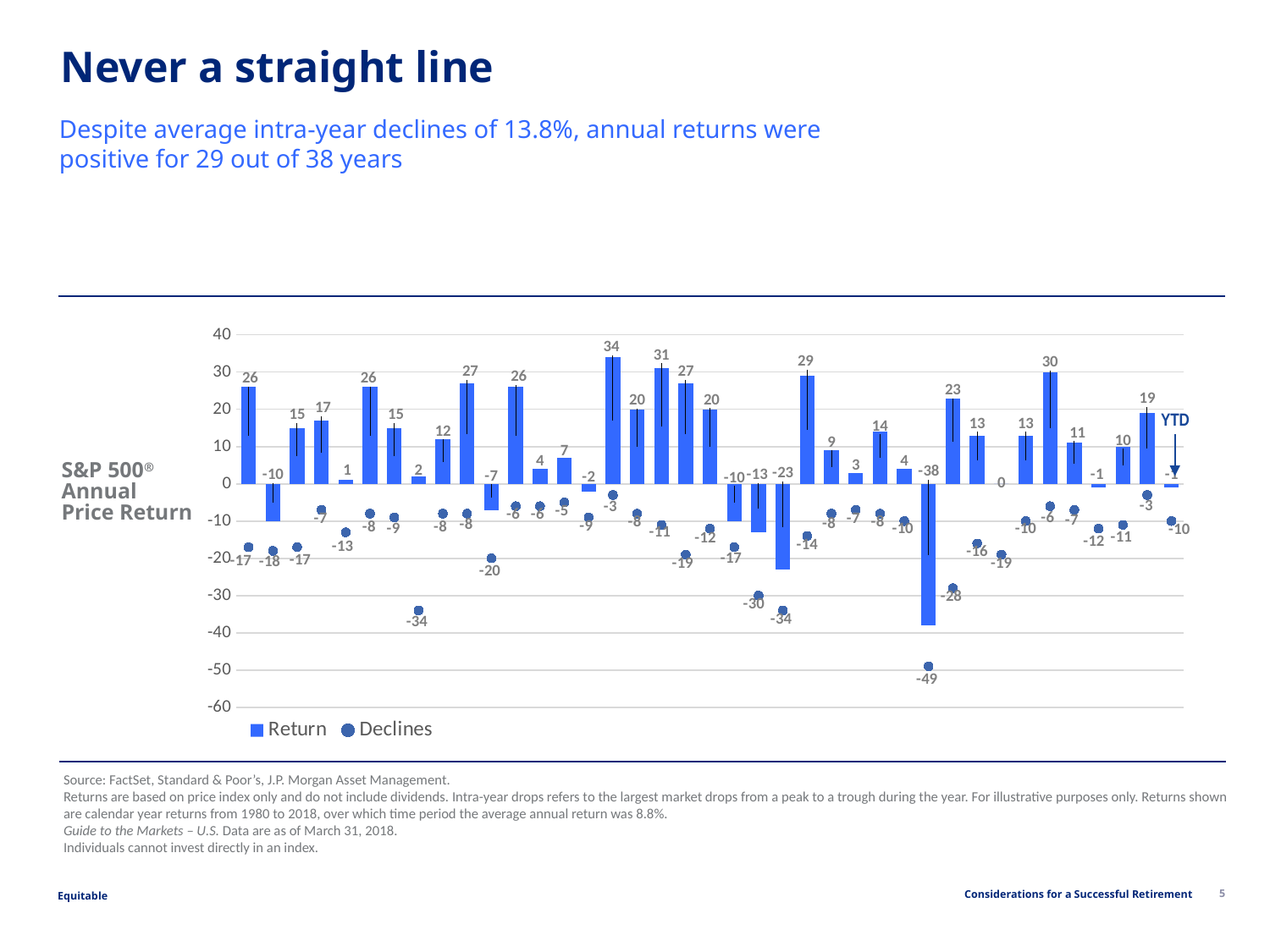
What is the largest intra-year decline shown on the chart? -49 What is the difference between the highest return (34) and the lowest return (-38)? 72 What is the lowest annual return value shown on the chart? -38 Is the lowest return bar (-38) greater or less than -30? less What is the label on the vertical axis of the chart? S&P 500 Annual Price Return What is the return value for the YTD bar? -1 What is the highest annual return value shown on the chart? 34 What are the two series named in the legend? Return and Declines What is the decline value for the YTD point? -10 What is the smallest intra-year decline value shown on the chart? -3 What kind of chart is used to show the annual returns? Bar chart How many series does the legend list? 2